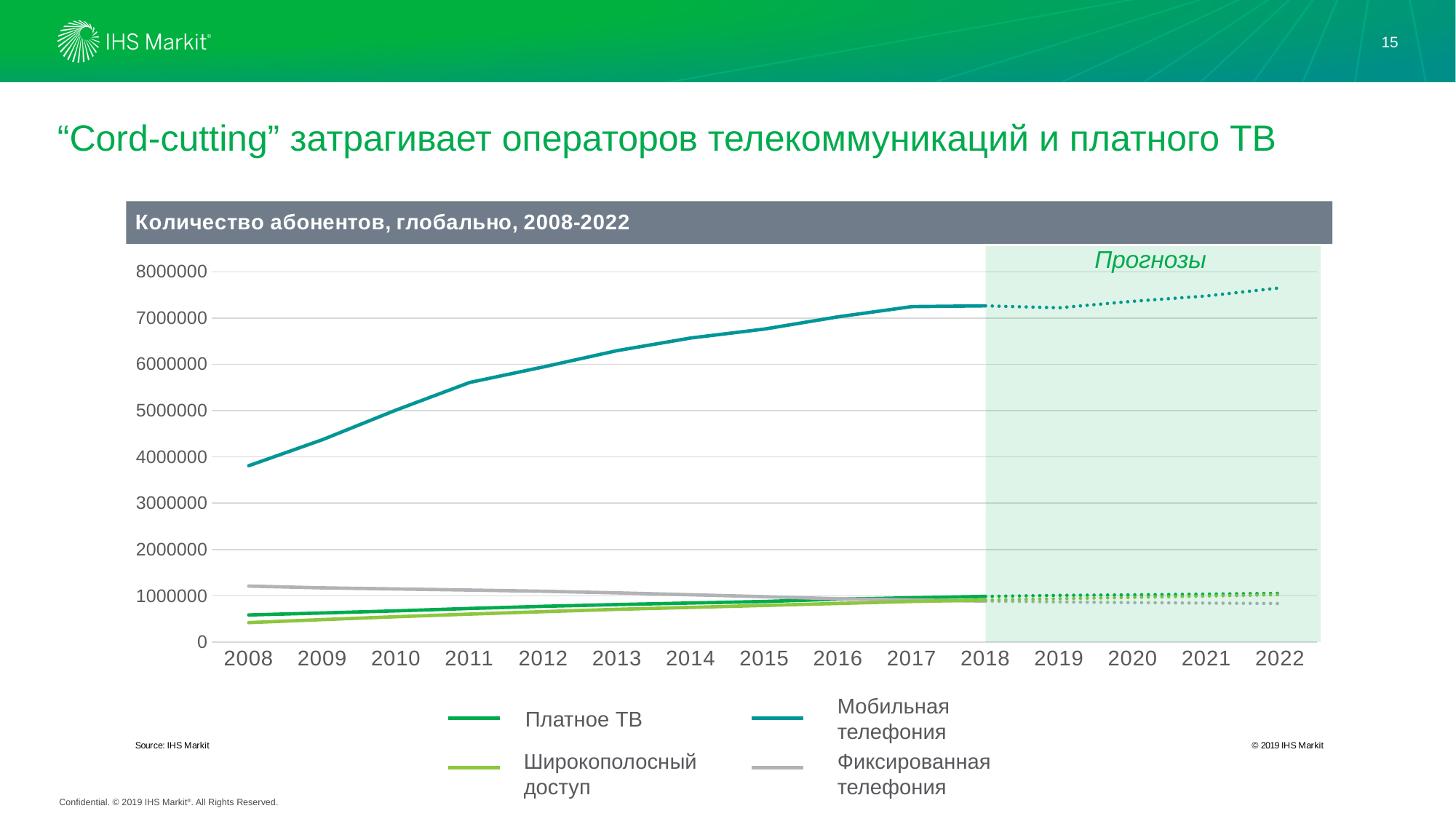
What kind of chart is shown on the slide? line chart In 2008, which is larger: Платное ТВ or Широкополосный доступ? Платное ТВ How many years are shown on the x axis? 15 What label is shown over the shaded area covering 2018-2022? Прогнозы Does the Фиксированная телефония line rise or fall from 2008 to 2018? falls How many series does the legend list? 4 Does the Мобильная телефония line rise or fall from 2008 to 2018? rises What is the title of the chart? Количество абонентов, глобально, 2008-2022 Which series has the lowest value in 2008? Широкополосный доступ Which series has the highest value in 2018? Мобильная телефония Is the value for Фиксированная телефония in 2008 greater or less than 1000000? greater Is the value for Мобильная телефония in 2017 greater or less than 7000000? greater